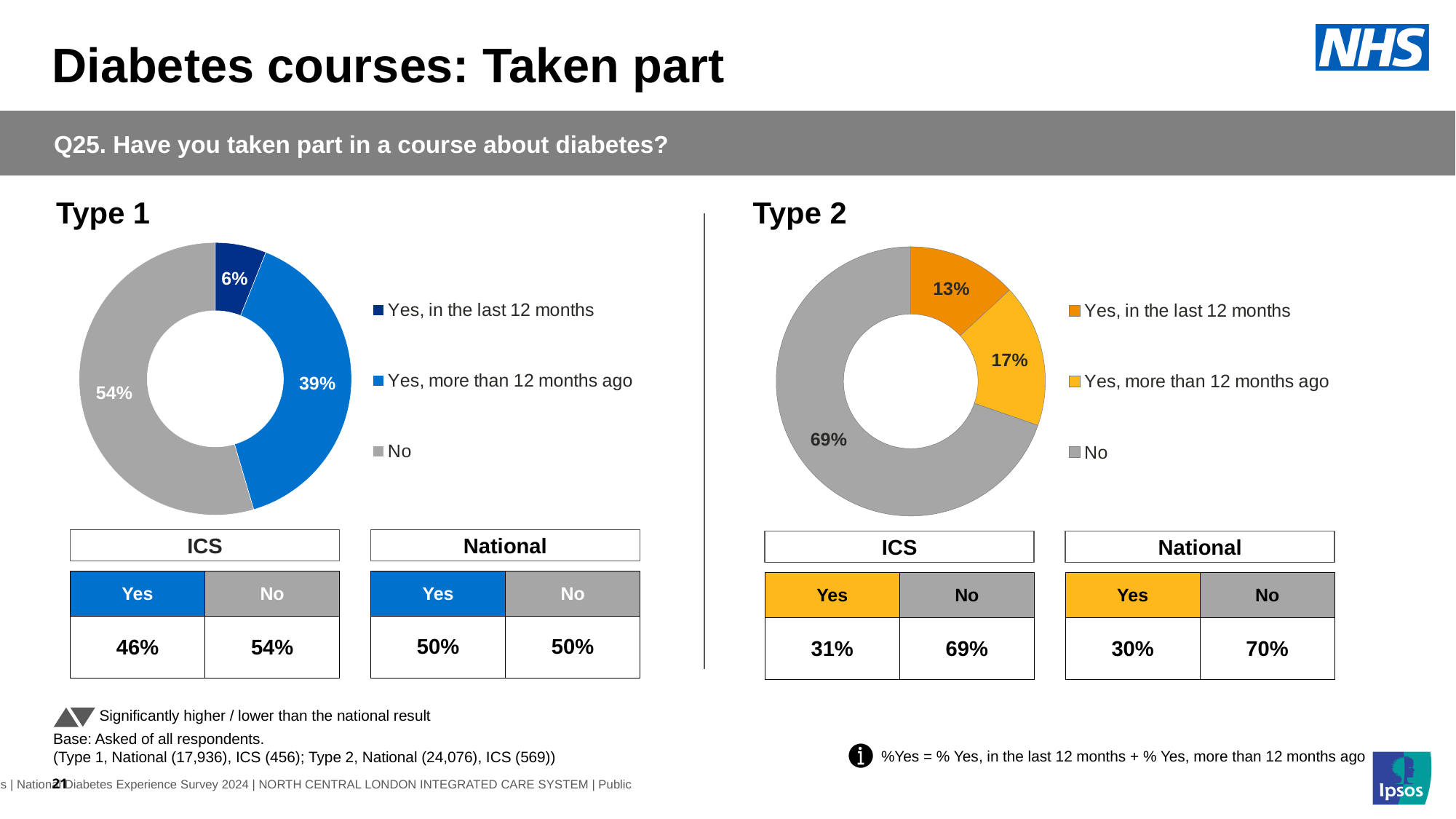
Which is larger: the 'Yes, in the last 12 months' share in the Type 1 chart or in the Type 2 chart? Type 2 In the Type 1 chart, what percentage of respondents answered 'Yes, more than 12 months ago'? 39% What kind of chart is used for Type 2? Doughnut chart How many categories does the Type 1 chart show? 3 In the Type 1 chart, which category has the largest share? No In the Type 2 chart, what is the difference between the 'No' share and the 'Yes, more than 12 months ago' share? 52 percentage points In the Type 2 chart, what colour represents 'Yes, in the last 12 months'? Orange In the Type 2 chart, which category has the smallest share? Yes, in the last 12 months In the Type 2 chart, what percentage of respondents answered 'No'? 69% In the Type 1 chart, what percentage of respondents answered 'Yes, in the last 12 months'? 6% In the Type 2 chart, what percentage of respondents answered 'Yes, more than 12 months ago'? 17% In the Type 1 chart, what is the combined share of the two 'Yes' categories? 45%